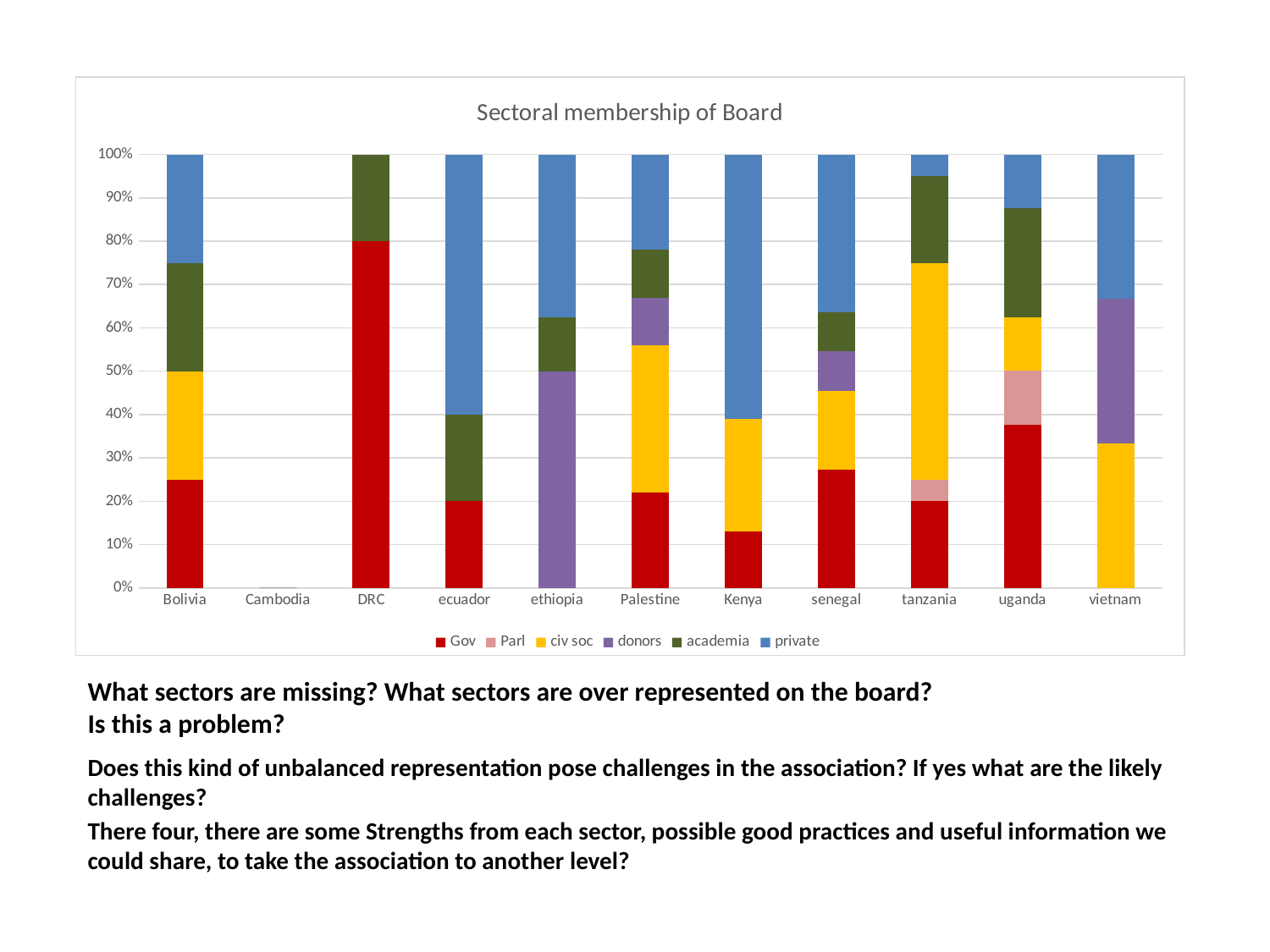
How many countries are shown on the x axis? 11 What is the title of the chart? Sectoral membership of Board Is the private share for Kenya greater or less than 50%? greater What kind of chart is shown on the slide? Stacked bar chart How many series does the legend list? 6 Which country on the x axis has no bar plotted? Cambodia What is the Gov share for DRC? 80% Which country has the largest Gov share of its board? DRC What is the Gov share for ecuador? 20% Is the Gov share for Kenya greater or less than 20%? less What is the donors share for ethiopia? 50% Which has a larger Gov share, DRC or Kenya? DRC